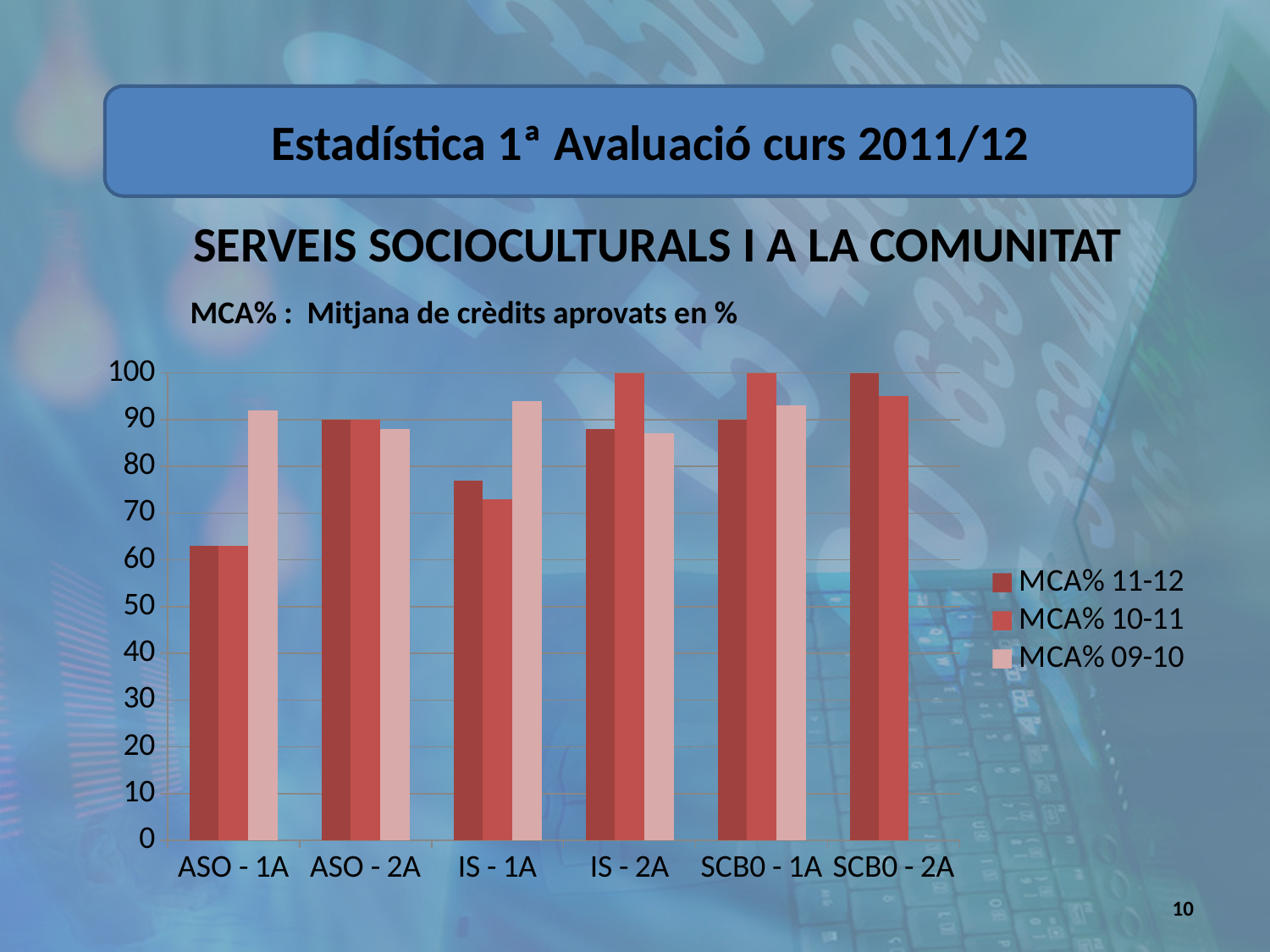
What is the MCA% 11-12 value for ASO - 2A? 90 What kind of chart is shown on the slide? bar chart What is the MCA% 11-12 value for SCB0 - 2A? 100 How many categories are shown on the x axis? 6 What does the text above the chart say MCA% stands for? Mitjana de crèdits aprovats en % Which category has the highest MCA% 11-12 value? SCB0 - 2A For ASO - 1A, which is larger: the MCA% 11-12 value or the MCA% 09-10 value? MCA% 09-10 Which category has the lowest MCA% 11-12 value? ASO - 1A Is the MCA% 11-12 value for ASO - 1A greater or less than 70? less Is the MCA% 11-12 value for IS - 1A greater or less than 80? less How many series does the legend list? 3 What is the MCA% 10-11 value for IS - 2A? 100